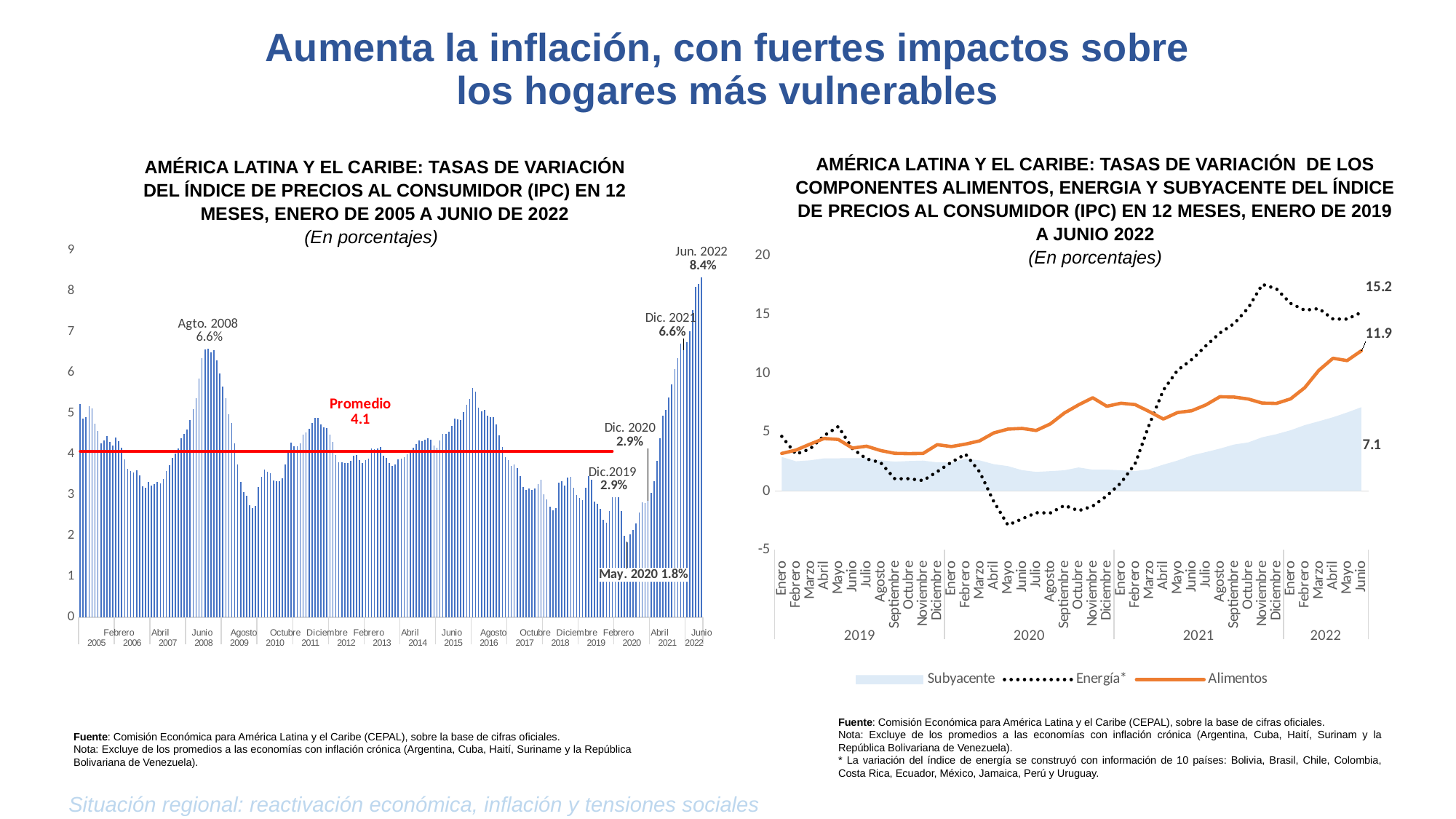
In the left chart, what is the value labelled for May. 2020? 1.8% In the right chart, what is the value labelled at the end of the Energía series (Junio 2022)? 15.2 In the right chart, what is the value labelled at the end of the Alimentos series (Junio 2022)? 11.9 In the right chart, which series has the highest value in Junio 2022? Energía How many series does the legend of the right chart list? 3 What kind of chart is the left chart? Bar chart with a horizontal average line (combination bar and line chart) In the left chart, which is larger: the value for Dic. 2021 or the value for Dic. 2020? Dic. 2021 In the right chart, is the Energía value in Mayo 2020 greater or less than 0? less In the left chart, what is the value of the 'Promedio' line? 4.1 In the left chart, what is the value labelled for Agto. 2008? 6.6% In the left chart (tasas de variación del IPC en 12 meses), what is the value labelled for Jun. 2022? 8.4% In the left chart, what is the difference between the Jun. 2022 value and the Dic. 2021 value? 1.8 percentage points